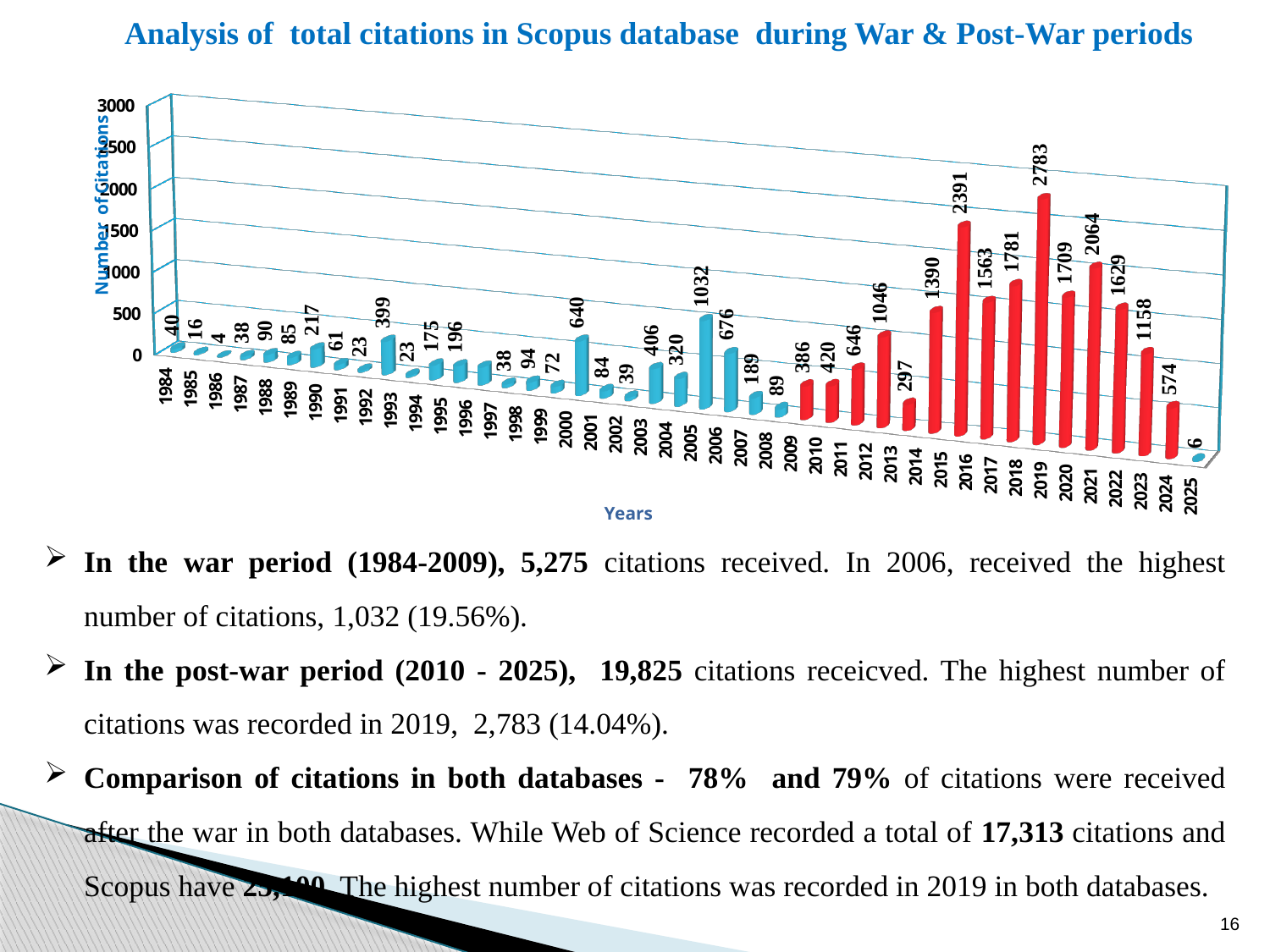
How many citations were recorded in 2019? 2783 What is the difference in citations between 2019 and 2016? 392 How many citations were recorded in 2024? 574 What is the title of the vertical axis of the chart? Number of citations Which year has the highest number of citations? 2019 Is the value for 2016 greater or less than 2000? greater What type of chart is shown on the slide? Bar chart How many years are shown on the x axis of the chart? 42 How many citations were recorded in 2006? 1032 Which year had more citations, 2020 or 2021? 2021 How many citations were recorded in 2023? 1158 How many citations were recorded in 2025? 6